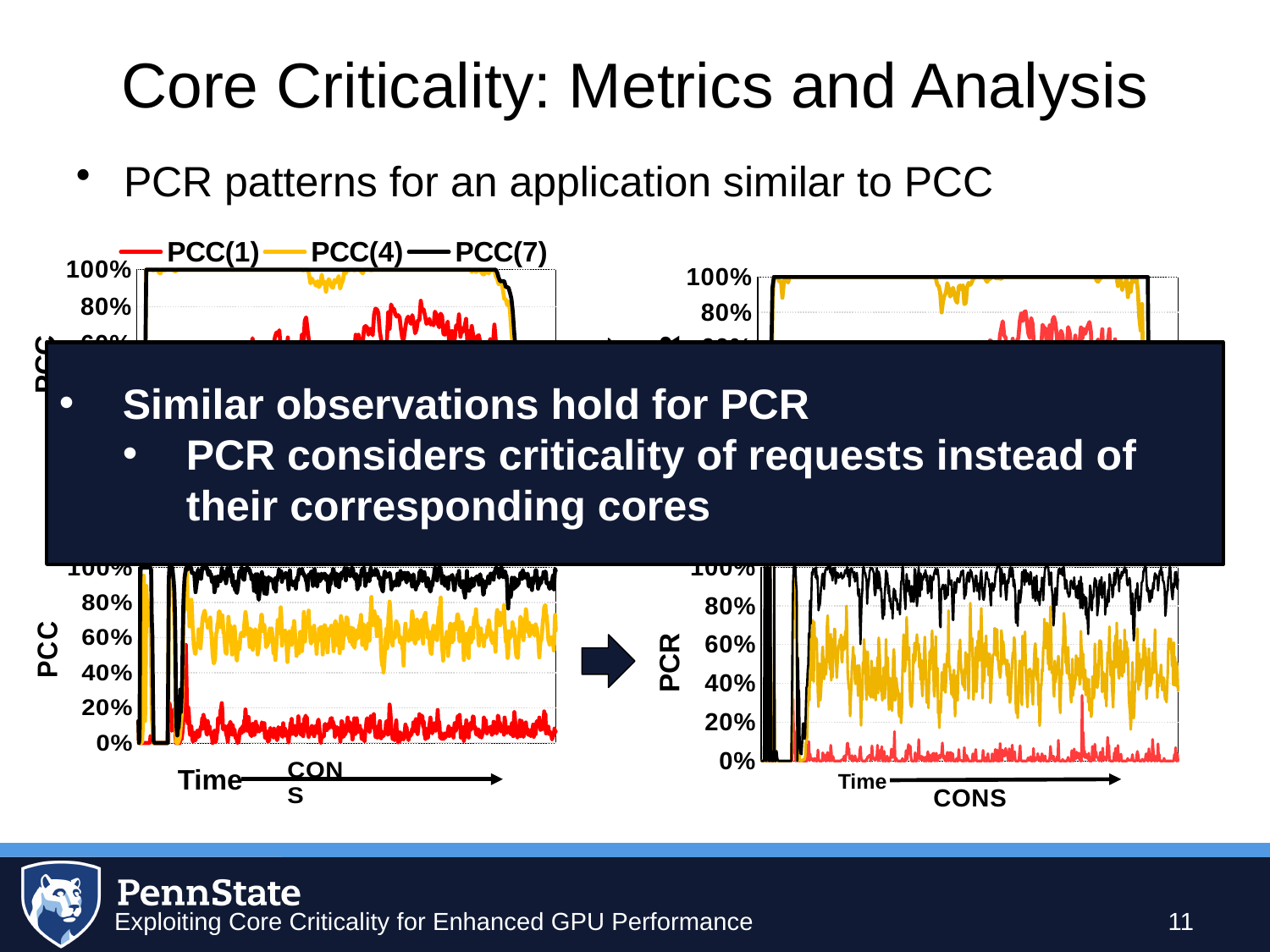
What are the three series names listed in the legend? PCC(1), PCC(4), PCC(7) In the bottom-left chart, is the PCC(7) line mostly greater or less than 80%? greater In the top-left chart, is the PCC(7) line mostly greater or less than 80%? greater How many series does the legend at the top of the slide list? 3 What is the y-axis label of the bottom-right chart? PCR What kind of chart is the bottom-left chart on the slide? line chart How many charts are shown on the slide? 4 In the bottom-left chart, is the PCC(1) line mostly greater or less than 20%? less In the bottom-left chart, which series is higher over most of the time axis, PCC(7) or PCC(1)? PCC(7)